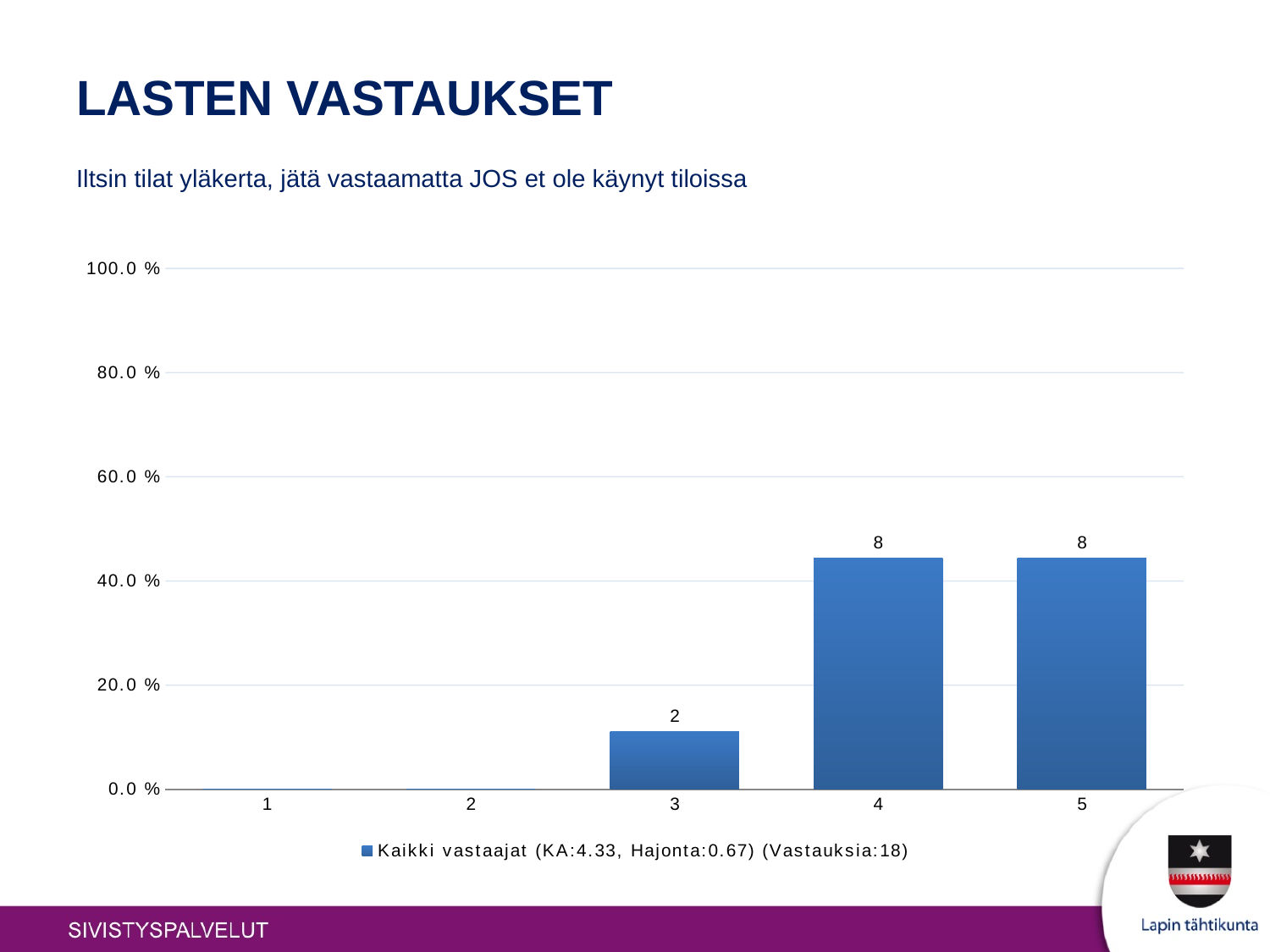
How many series does the legend list? 1 What is the highest value shown on the y axis? 100.0 % Which of categories 3 and 4 has the larger value? 4 Is the bar for category 3 greater or less than 20.0 % on the axis? less What is the data label on the bar for category 3? 2 What is the data label on the bar for category 4? 8 What kind of chart is shown on the slide? bar chart How many responses (Vastauksia) does the legend entry report? 18 How many categories are shown on the x axis? 5 Is the bar for category 4 greater or less than 40.0 % on the axis? greater What is the difference between the data labels for category 4 and category 3? 6 What is the data label on the bar for category 5? 8